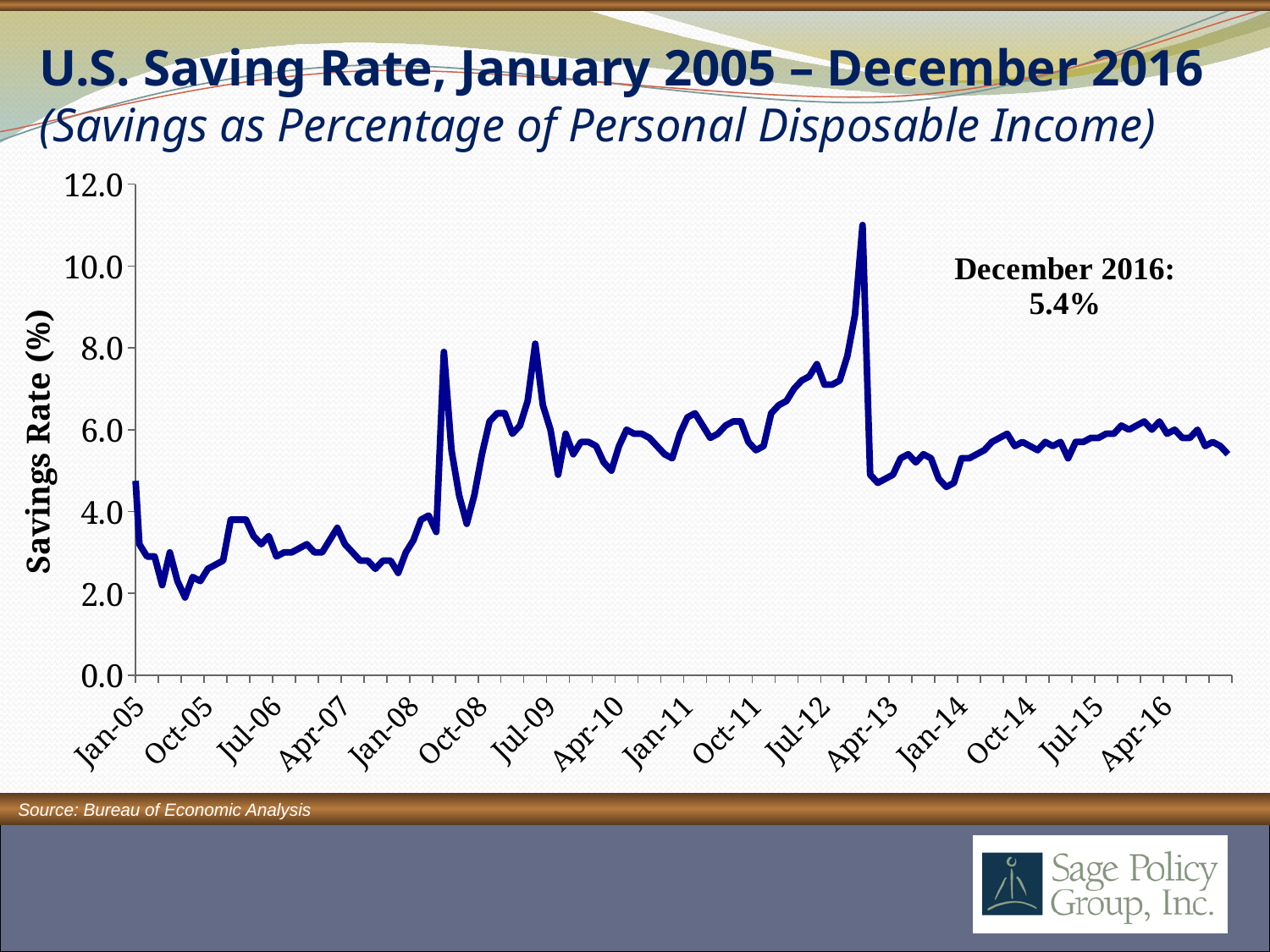
What is the title of the y-axis? Savings Rate (%) Is the value for Jan-08 greater or less than 4.0? less Do the values rise or fall from Jan-05 to Oct-05? fall What source is cited for the chart data? Bureau of Economic Analysis Is the highest value on the chart greater or less than 10.0? greater What kind of chart is shown on the slide? line chart What is the saving rate for December 2016 according to the annotation on the chart? 5.4% Between which two x-axis labels does the highest peak of the line occur? Jul-12 and Apr-13 Is the value for Oct-05 greater or less than 4.0? less Which is larger, the value at Oct-05 or the value at Oct-08? Oct-08